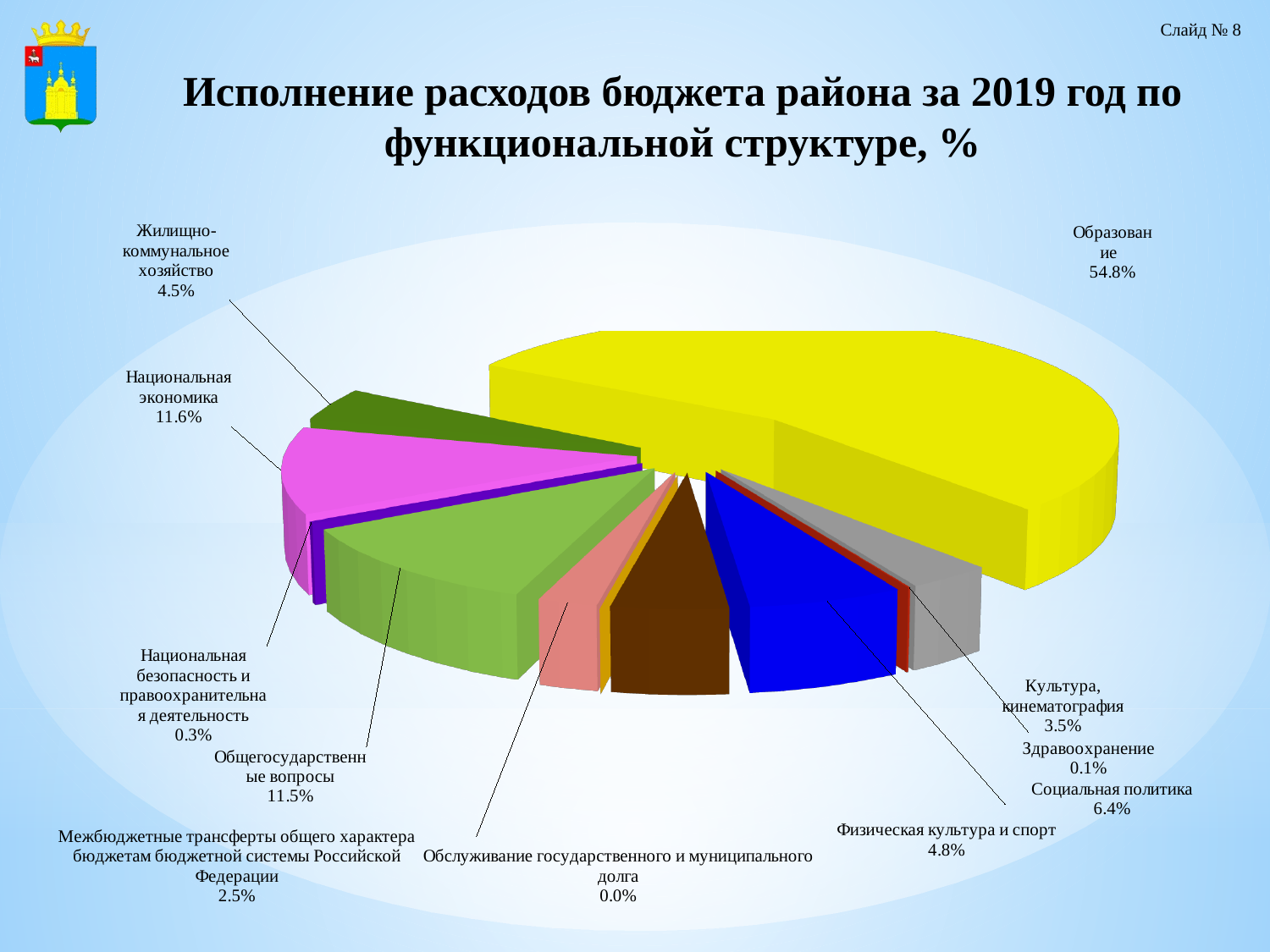
What kind of chart is shown on the slide? Pie chart What share of the budget expenditure goes to Образование? 54.8% Which category has the smallest share of the pie? Обслуживание государственного и муниципального долга What percentage is shown for Социальная политика? 6.4% What is the difference between the shares of Образование and Национальная экономика? 43.2 percentage points Which is larger: the share for Физическая культура и спорт or the share for Социальная политика? Социальная политика What is the difference between the shares of Национальная экономика and Общегосударственные вопросы? 0.1 percentage points What is the value shown for Национальная экономика? 11.6% Which category has the largest share of the pie? Образование What is the value for Жилищно-коммунальное хозяйство? 4.5% How many categories are shown in the pie chart? 11 What share is shown for Культура, кинематография? 3.5%